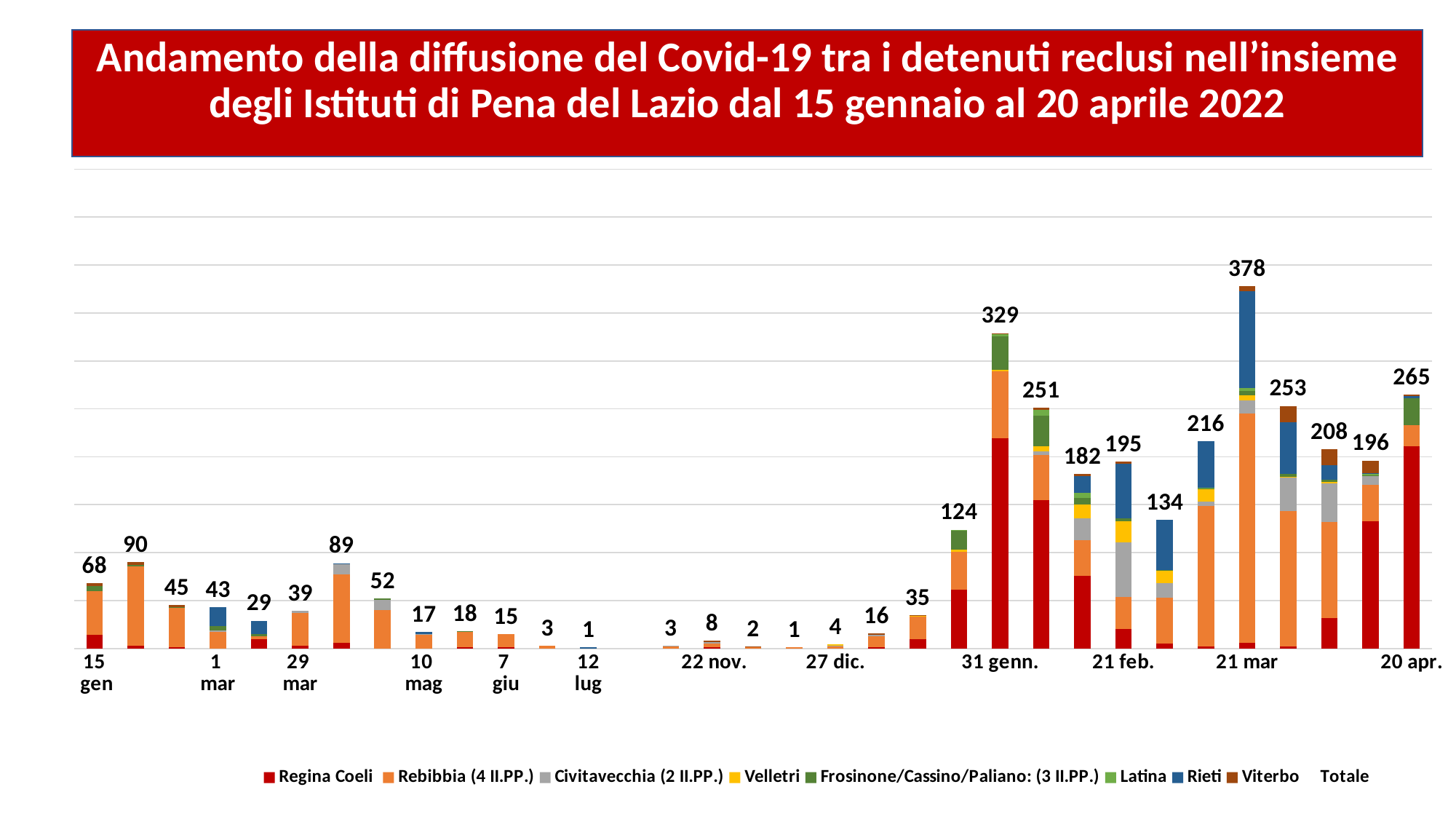
What is the total value shown for 21 feb.? 195 How many series does the legend list? 9 Which labelled date has the highest total? 21 mar What is the difference between the totals for 21 mar and 31 genn.? 49 What is the total value shown for 31 genn.? 329 Which has a larger total, 31 genn. or 20 apr.? 31 genn. What is the total value labelled above the bar for 21 mar? 378 What colour represents Regina Coeli in the chart? Red What kind of chart is shown on the slide? Stacked bar chart What is the lowest total value labelled on any bar in the chart? 1 What is the total number of infected detainees shown for 15 gen? 68 What is the total value shown for 20 apr.? 265